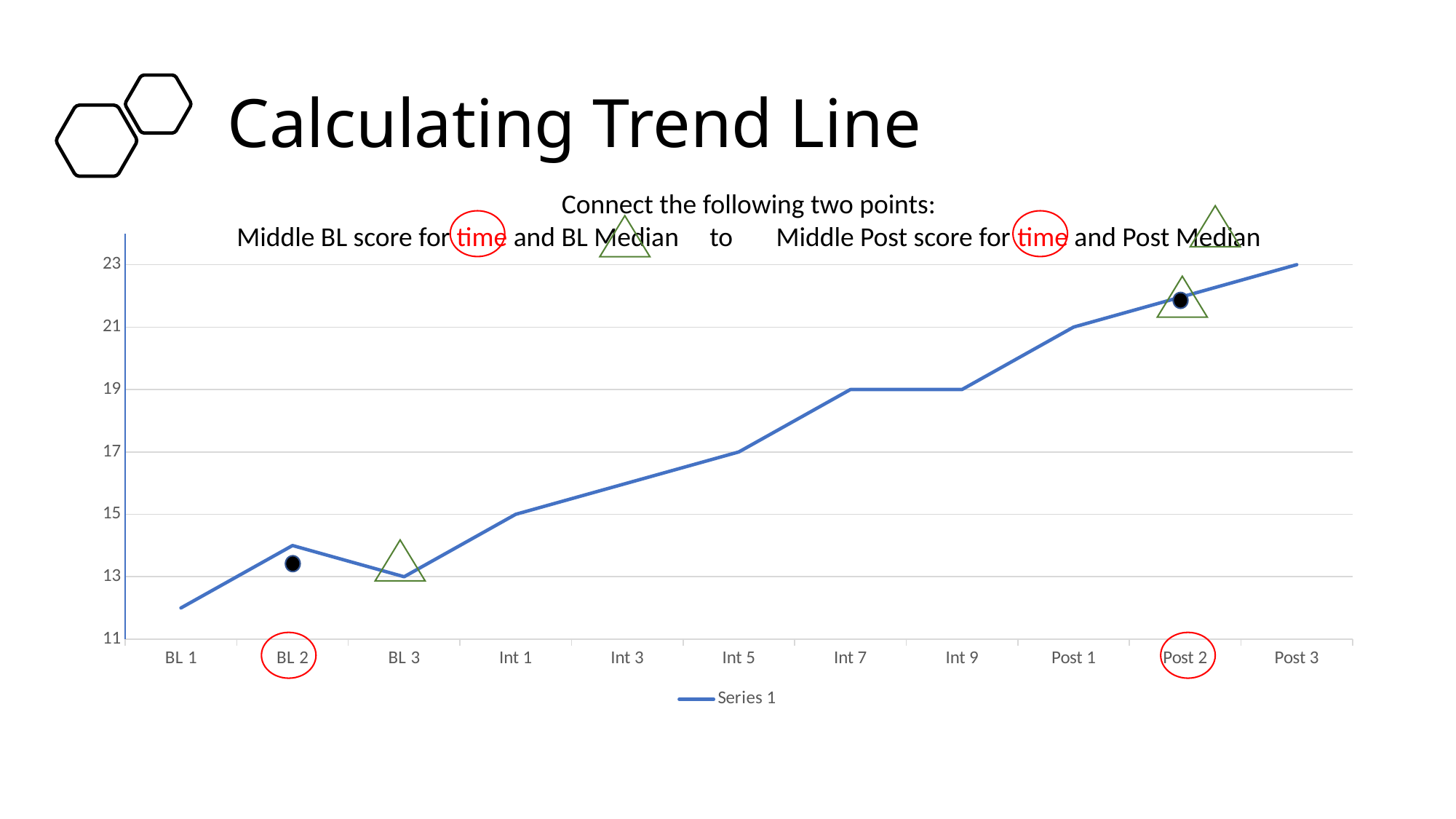
Which category has the lowest value? BL 1 Is the value for BL 1 greater or less than 13? less Which category has the highest value? Post 3 What is the name of the series shown in the legend? Series 1 What is the value for BL 3? 13 How many series does the chart legend list? 1 What kind of chart is shown on the slide? line chart Do the values generally rise or fall from BL 1 to Post 3? rise What is the value for Post 1? 21 How many categories are shown on the x axis of the chart? 11 Is the value for Post 2 greater or less than 21? greater What is the value for Int 7? 19